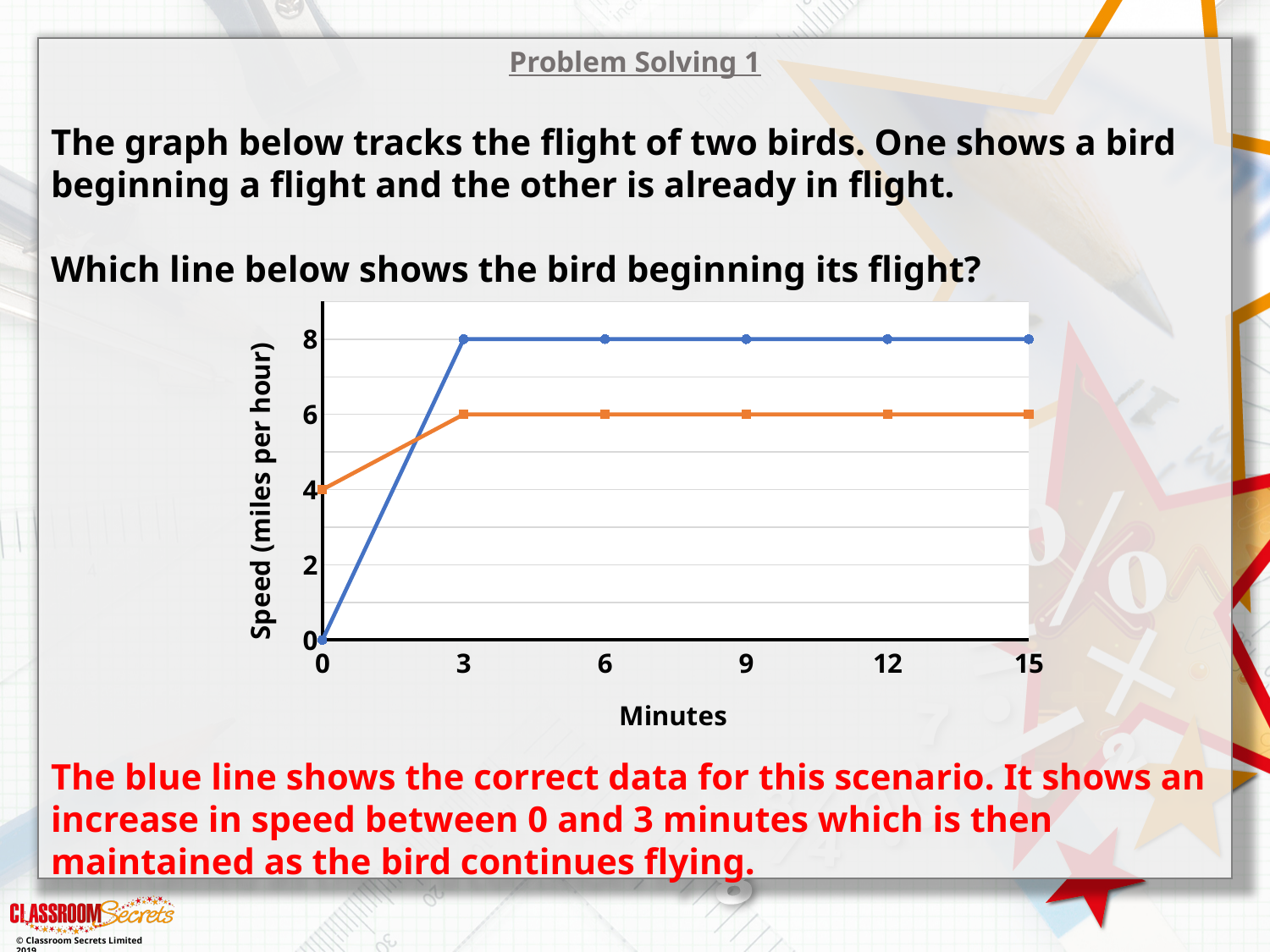
At 12 minutes, which line shows the higher speed, blue or orange? blue How many points are plotted on the blue line? 6 What is the speed shown by the orange line at 6 minutes? 6 What is the speed shown by the blue line at 0 minutes? 0 What is the speed shown by the blue line at 3 minutes? 8 What is the label of the y axis? Speed (miles per hour) What is the speed shown by the orange line at 0 minutes? 4 At 0 minutes, which line shows the higher speed, blue or orange? orange Does the blue line rise or fall between 0 and 3 minutes? rise What kind of chart is shown on the slide? line chart What is the difference between the blue line and the orange line at 9 minutes? 2 What is the label of the x axis? Minutes